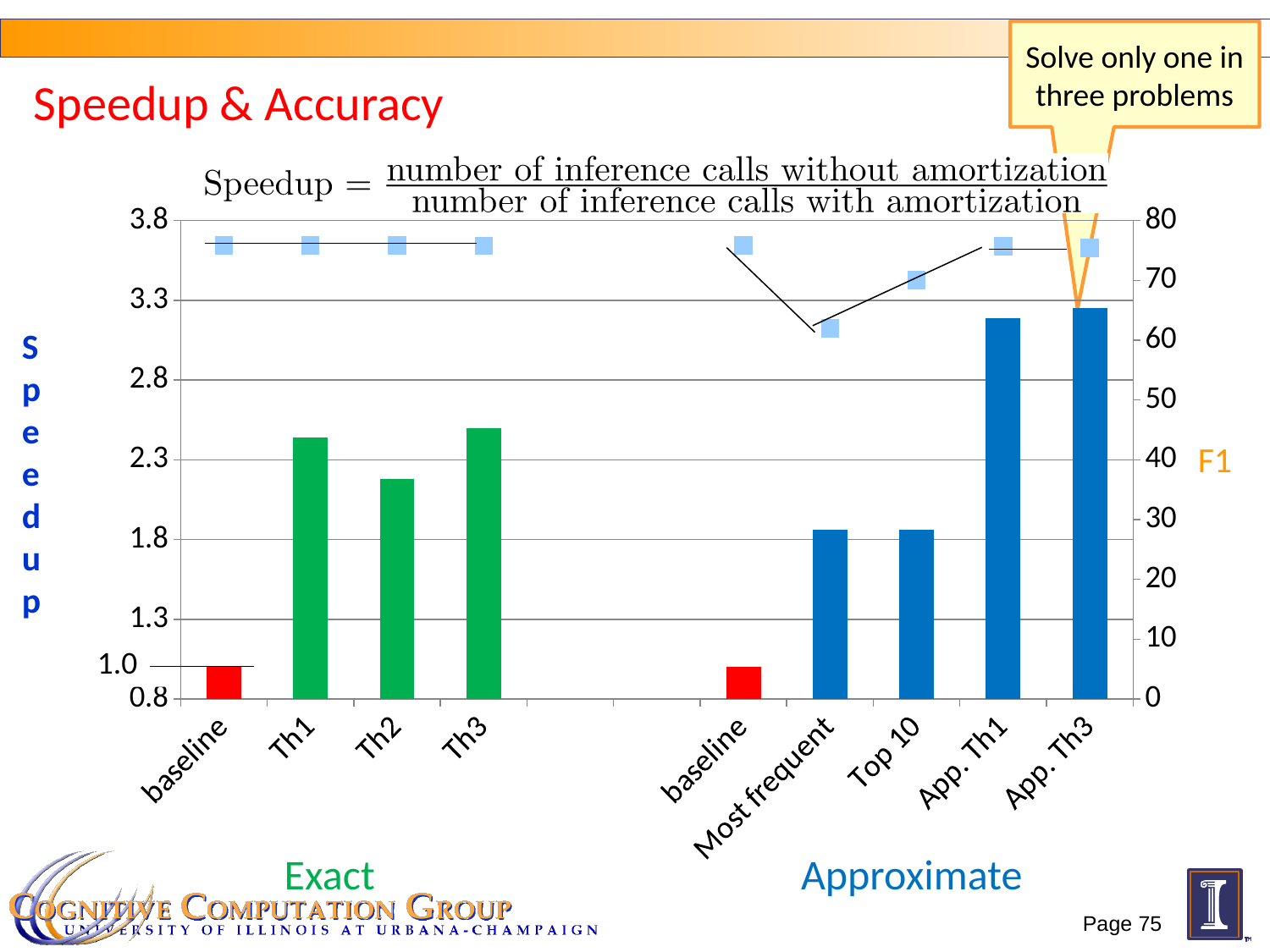
Is the speedup for App. Th1 greater or less than 2.8? greater Is the speedup for Th1 greater or less than 2.3? greater What kind of chart is shown on the slide? bar chart Is the speedup for Most frequent greater or less than 2.3? less Which has the larger speedup, Th1 or Th2? Th1 What is the speedup value for the baseline in the Exact group? 1.0 Which has the larger speedup, App. Th1 or Th3? App. Th1 What is the title of the slide's chart? Speedup & Accuracy What label is shown on the right-hand axis of the chart? F1 How many categories are shown along the x axis of the chart? 9